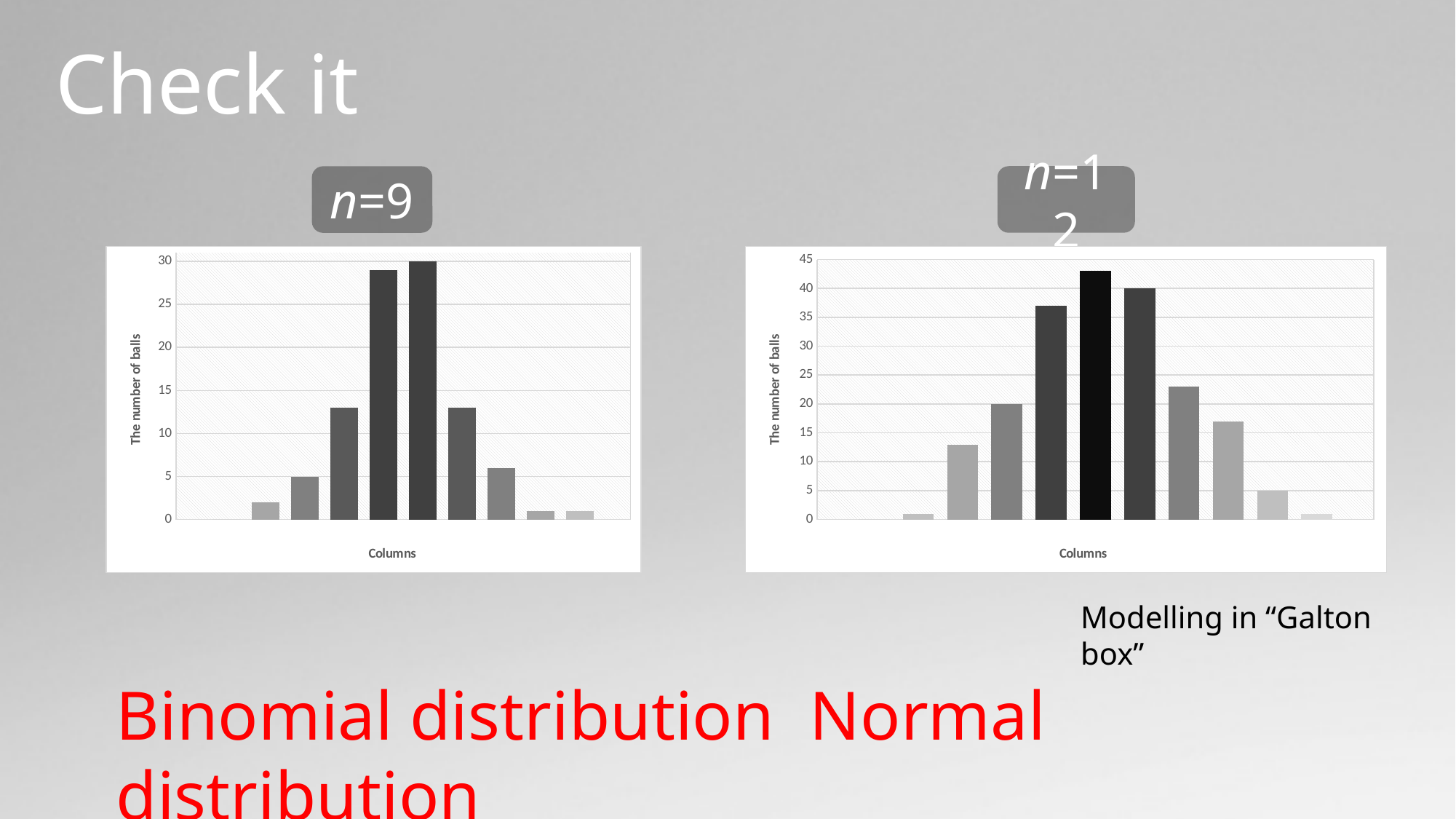
In the left chart (n=9), is the value of the second bar from the left greater or less than 10? less What kind of chart is the right chart (n=12)? bar chart In the right chart (n=12), do the bar values rise or fall from the leftmost bar to the tallest bar? rise What kind of chart is the left chart (n=9)? bar chart What is the y-axis title of the left chart (n=9)? The number of balls How many bars are plotted in the left chart (n=9)? 9 In the left chart (n=9), what value does the tallest bar reach on the y axis? 30 What is the x-axis title of the right chart (n=12)? Columns How many bars are plotted in the right chart (n=12)? 10 In the right chart (n=12), is the value of the tallest bar greater or less than 40? greater In the left chart (n=9), which is larger: the tallest bar or the leftmost bar? the tallest bar In the right chart (n=12), is the value of the tallest bar greater or less than 45? less